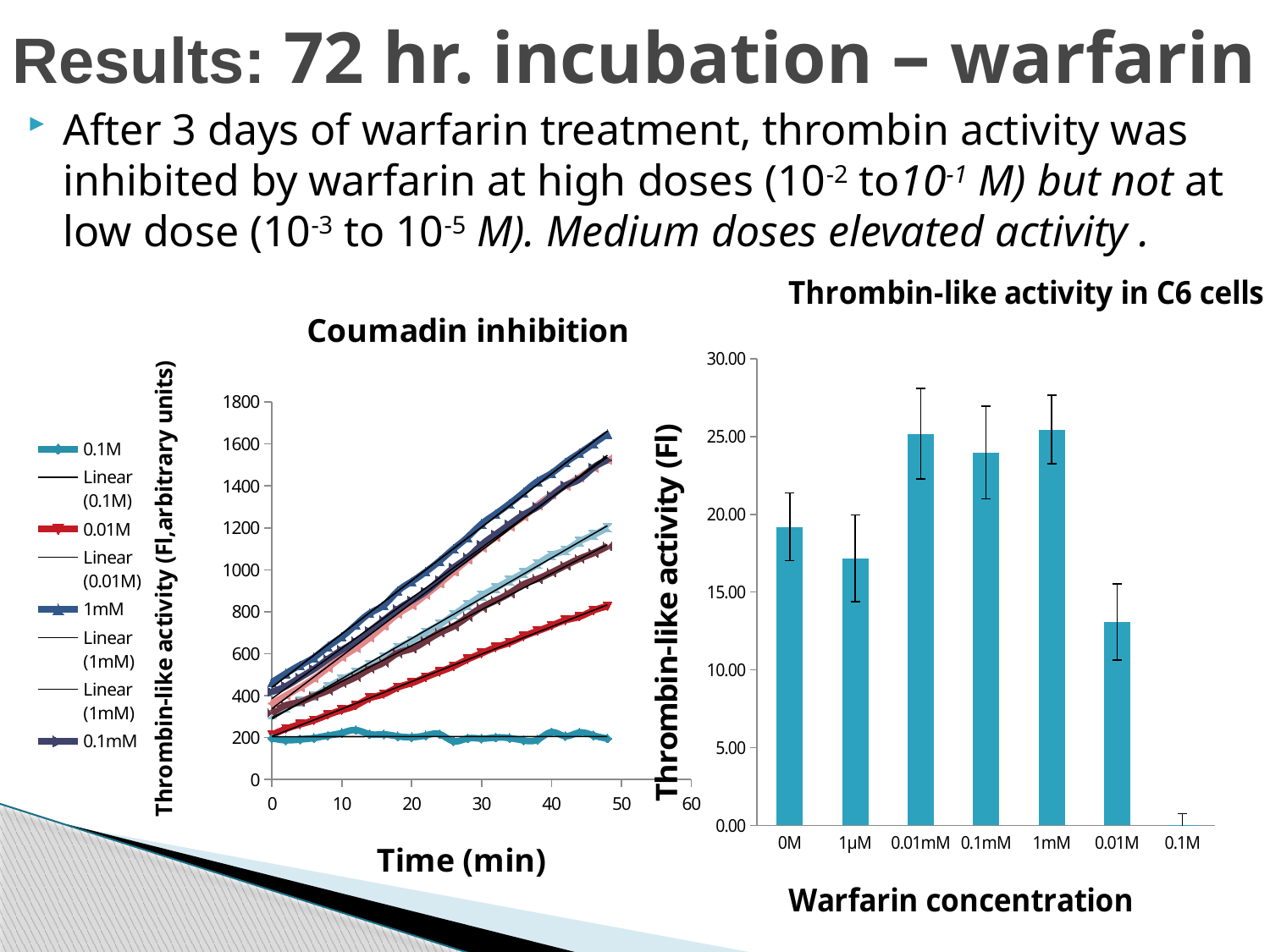
What kind of chart is the 'Thrombin-like activity in C6 cells' chart? bar chart In the 'Thrombin-like activity in C6 cells' chart, is the value for 0.01M greater or less than 15.00? less In the 'Thrombin-like activity in C6 cells' chart, is the value for 0M greater or less than 15.00? greater How many entries does the legend of the 'Coumadin inhibition' chart list? 8 In the 'Coumadin inhibition' chart, is the value of the 0.1M series at 40 min greater or less than 400? less What kind of chart is the 'Coumadin inhibition' chart? line chart In the 'Thrombin-like activity in C6 cells' chart, which warfarin concentration has the lowest thrombin-like activity? 0.1M What is the x-axis label of the 'Thrombin-like activity in C6 cells' chart? Warfarin concentration In the 'Thrombin-like activity in C6 cells' chart, which is larger, the value for 0.01mM or the value for 0.01M? 0.01mM How many warfarin concentration categories are shown on the x axis of the 'Thrombin-like activity in C6 cells' chart? 7 In the 'Coumadin inhibition' chart, does the 1mM series rise or fall as time increases? rise